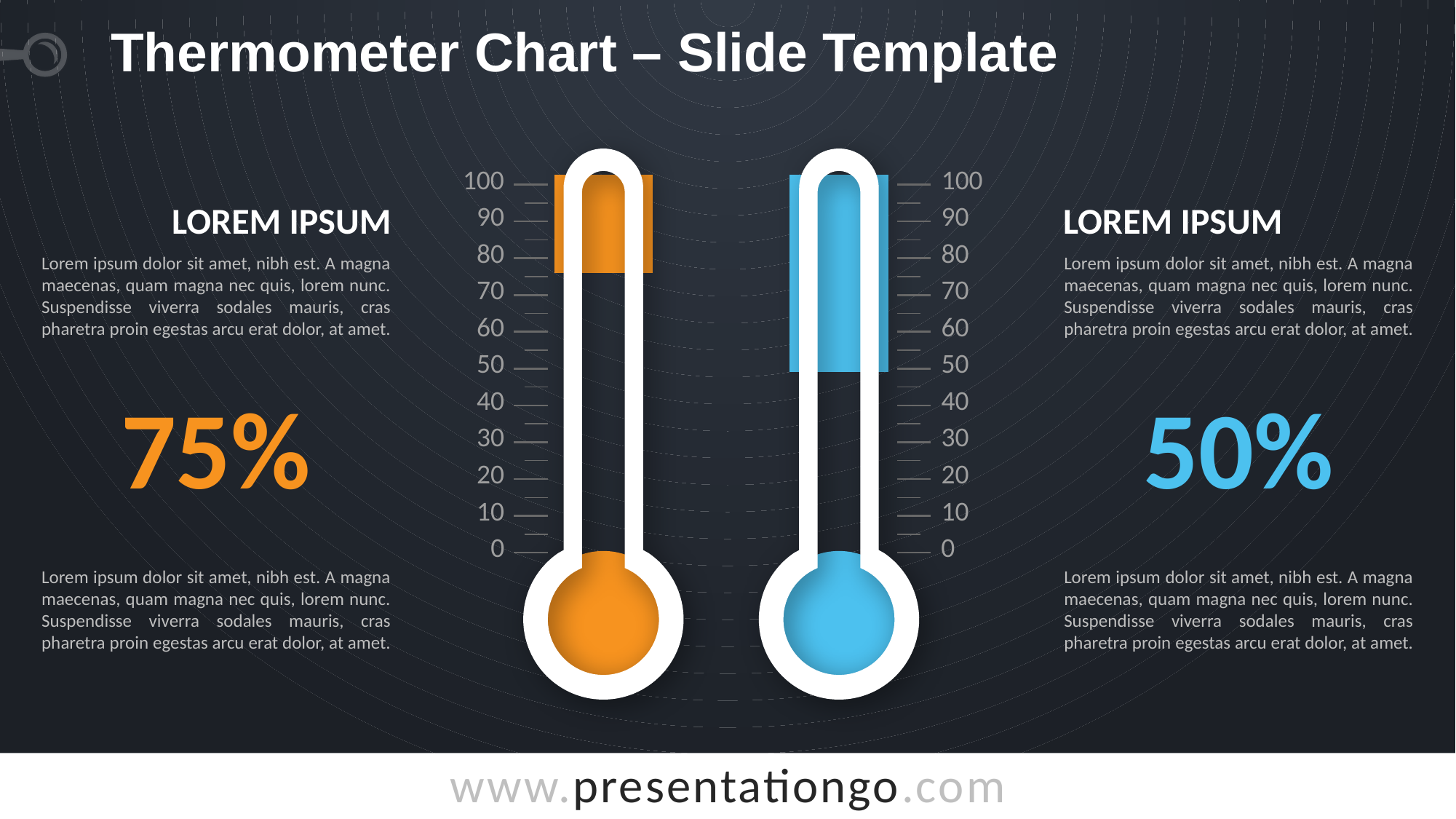
What value is shown for the right (blue) thermometer chart? 50% Which thermometer shows the higher value, the orange one on the left or the blue one on the right? the orange one on the left Which thermometer shows the lowest value? the blue one on the right What is the minimum value marked on the thermometer scales? 0 Is the value shown for the left (orange) thermometer greater or less than 50? greater What is the difference between the left thermometer's value (75%) and the right thermometer's value (50%)? 25% What value is shown for the left (orange) thermometer chart? 75% What is the title of the slide? Thermometer Chart – Slide Template Is the value shown for the right (blue) thermometer greater or less than 70? less How many thermometer charts are shown on the slide? 2 What is the maximum value marked on the thermometer scales? 100